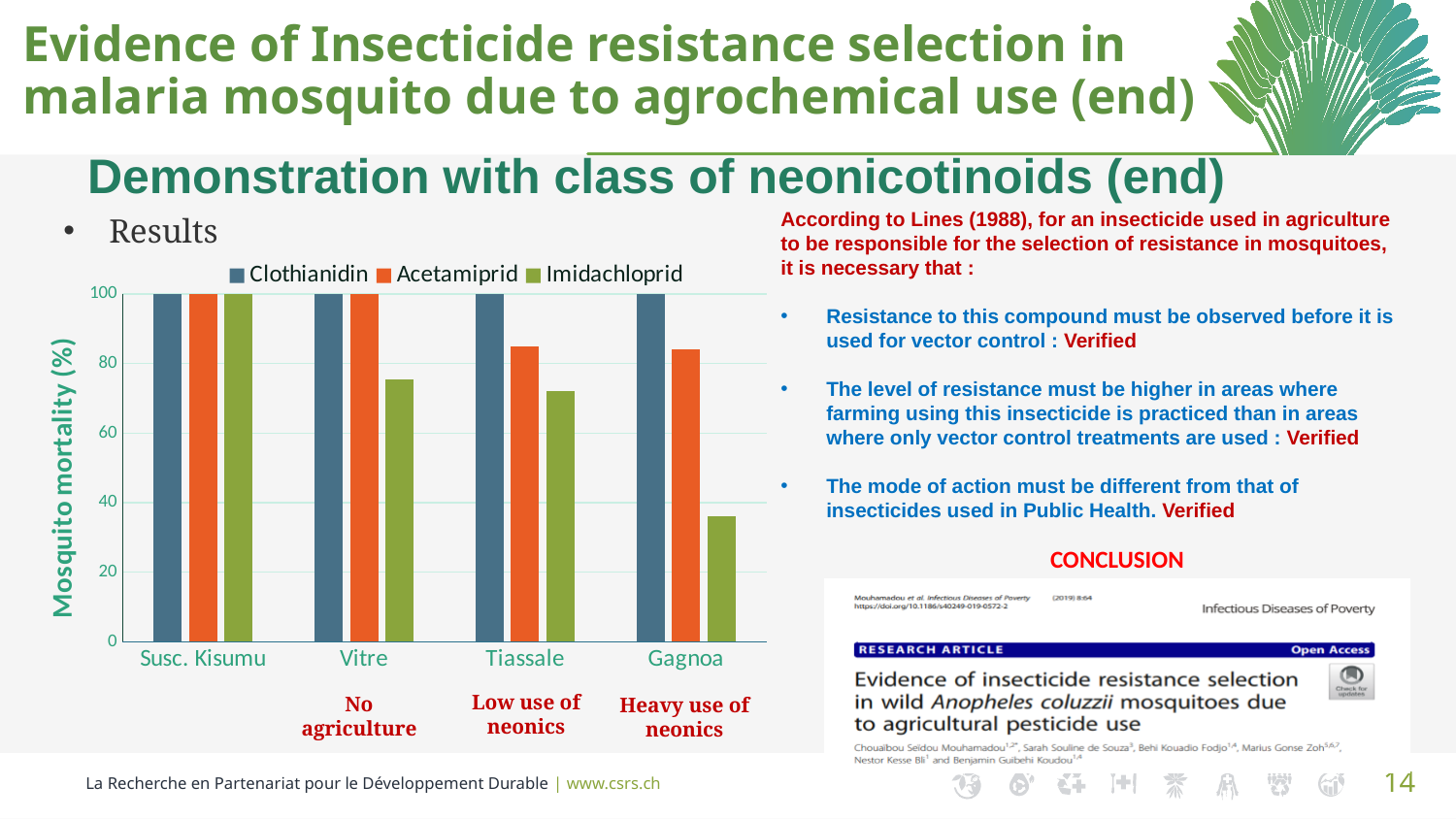
What kind of chart is shown on the slide? Bar chart What is the mosquito mortality for Clothianidin at Susc. Kisumu? 100 How many series does the chart's legend list? 3 Is the Acetamiprid value for Tiassale greater or less than 80? greater What is the title of the chart's y axis? Mosquito mortality (%) Which series is shown in orange in the chart's legend? Acetamiprid Which category has the lowest Imidachloprid mortality? Gagnoa Is the Imidachloprid value for Vitre greater or less than 60? greater Do the Imidachloprid values rise or fall from Susc. Kisumu to Gagnoa? fall How many categories are shown along the x axis of the chart? 4 Is the Imidachloprid value for Gagnoa greater or less than 40? less At Tiassale, which is larger: the Acetamiprid value or the Imidachloprid value? Acetamiprid